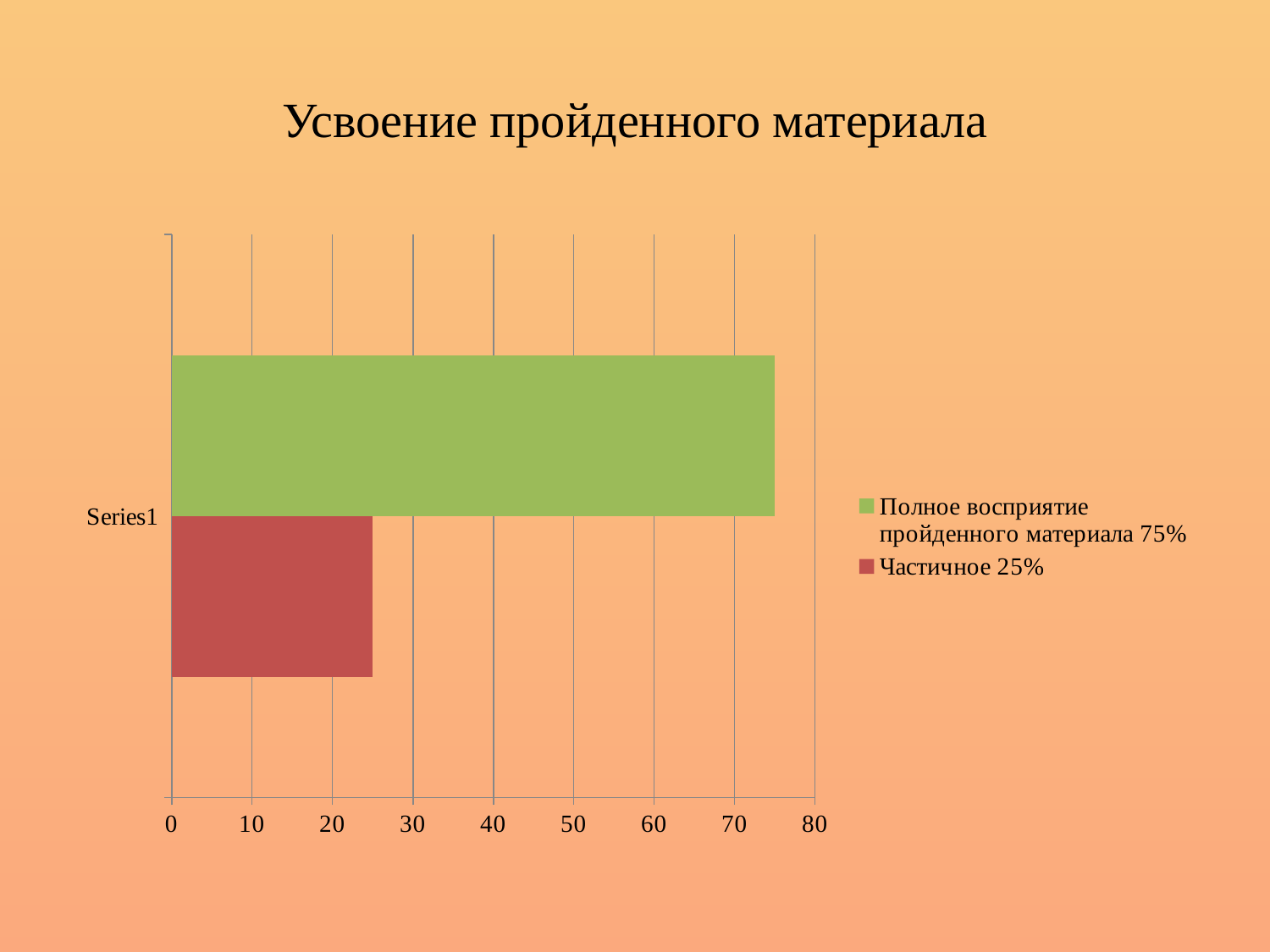
Is the value for 'Частичное' greater or less than 30? less According to the legend, what percentage corresponds to 'Полное восприятие пройденного материала'? 75% What is the name of the category on the vertical axis? Series1 Which series has the shorter bar? Частичное 25% How many series does the legend list? 2 What is the difference between the percentages for 'Полное восприятие пройденного материала' and 'Частичное' as given in the legend? 50% According to the legend, what percentage corresponds to 'Частичное'? 25% What is the title of the chart? Усвоение пройденного материала What kind of chart is shown on the slide? bar chart Is the value for 'Полное восприятие пройденного материала' greater or less than 70? greater Which series has the longer bar? Полное восприятие пройденного материала 75% How many categories are shown on the vertical axis? 1